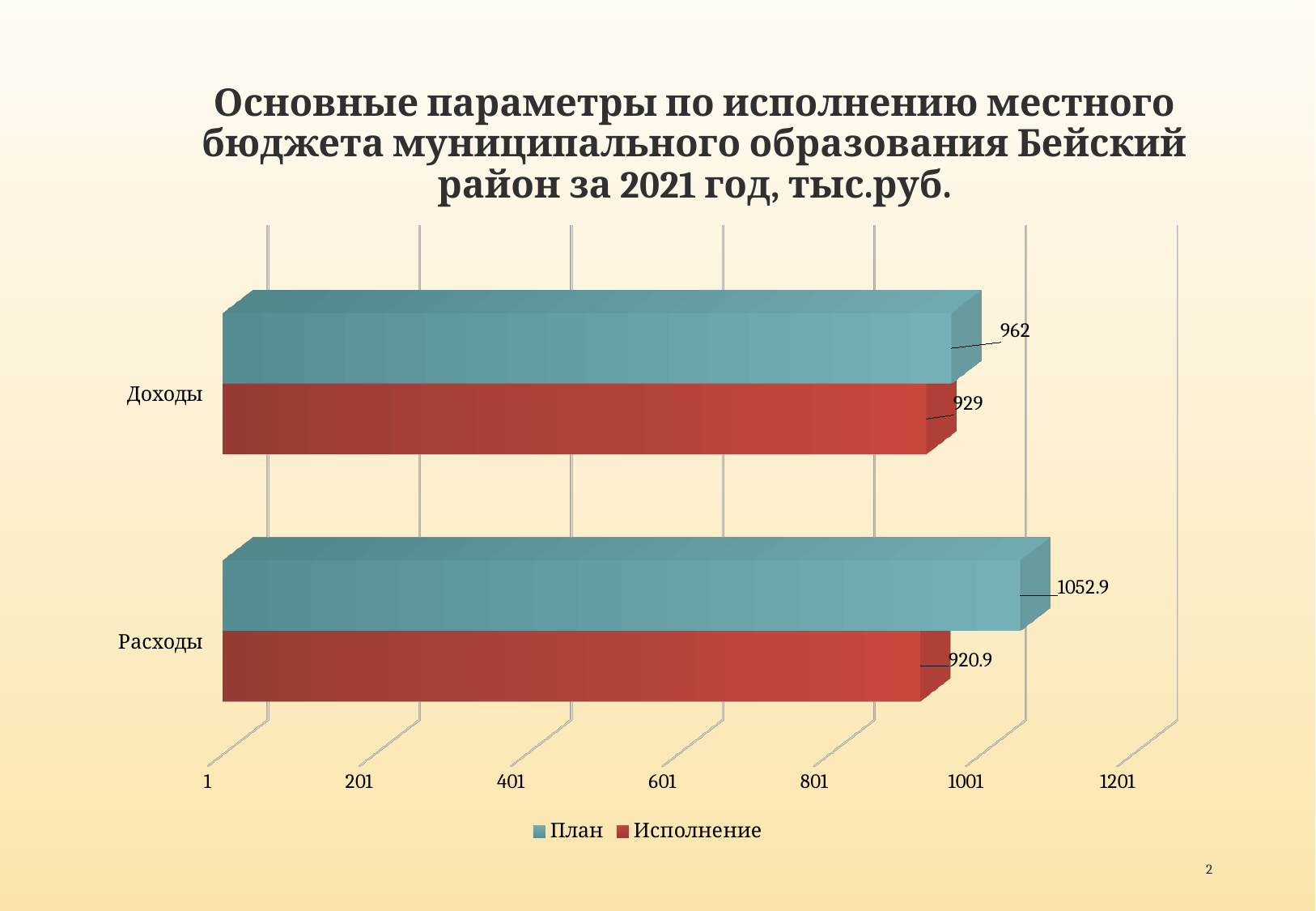
Which is larger: the План value for Расходы or the План value for Доходы? Расходы What is the План value for Доходы? 962 How many series does the legend list? 2 Which category has the highest План value? Расходы What is the difference between the План and Исполнение values for Расходы? 132 What kind of chart is shown on the slide? Bar chart What is the Исполнение value for Расходы? 920.9 What is the Исполнение value for Доходы? 929 Which category has the lowest Исполнение value? Расходы What is the difference between the План and Исполнение values for Доходы? 33 What is the План value for Расходы? 1052.9 How many categories are shown on the chart? 2